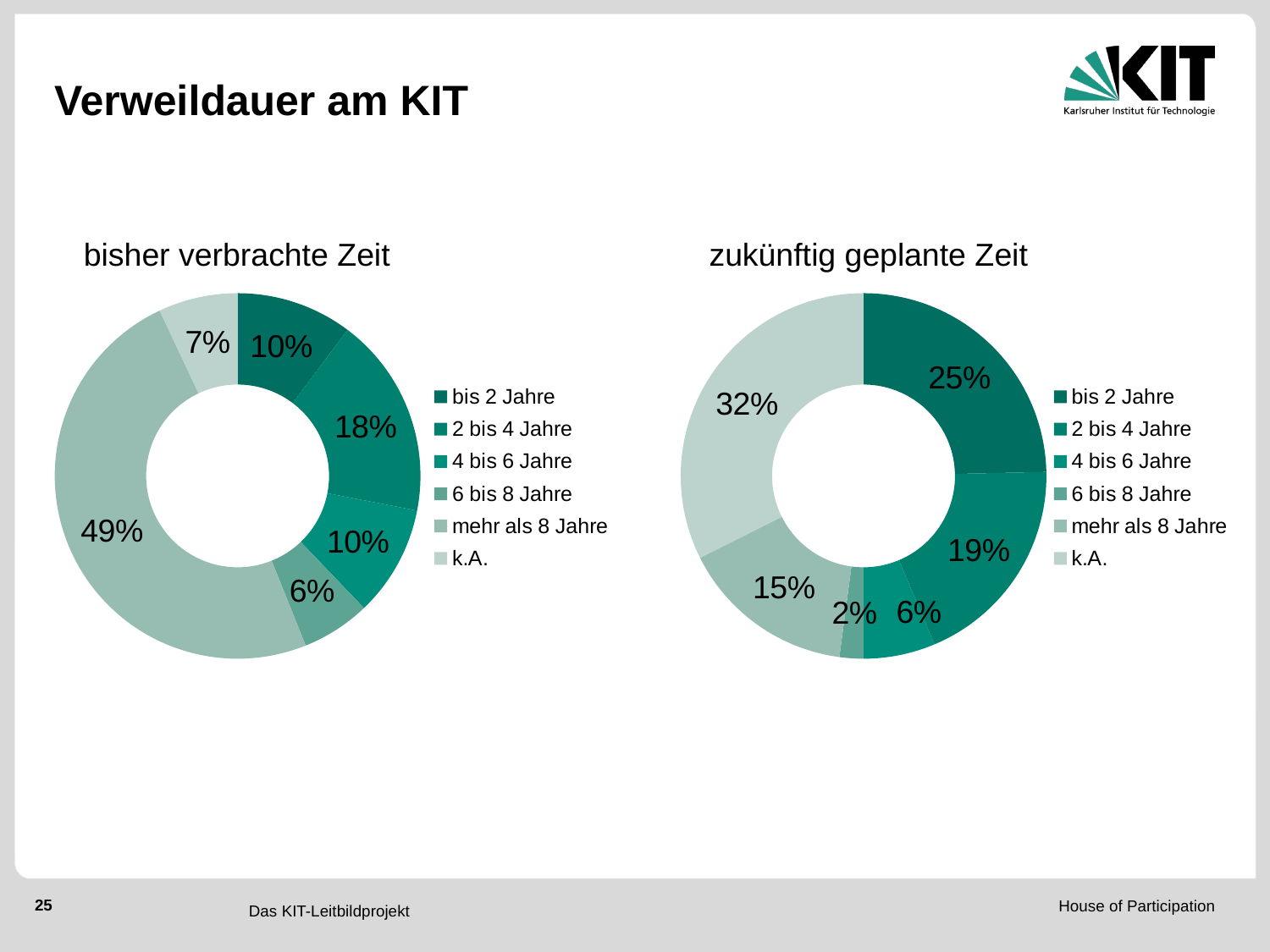
In the chart titled "zukünftig geplante Zeit", what share is shown for "k.A."? 32% In the chart titled "bisher verbrachte Zeit", what is the difference between the shares for "2 bis 4 Jahre" and "6 bis 8 Jahre"? 12% In the chart titled "bisher verbrachte Zeit", what share is shown for "2 bis 4 Jahre"? 18% What type of chart is used for "zukünftig geplante Zeit"? Donut (pie) chart In the chart titled "zukünftig geplante Zeit", what is the difference between the shares for "k.A." and "mehr als 8 Jahre"? 17% In the chart titled "bisher verbrachte Zeit", what share is shown for "mehr als 8 Jahre"? 49% Which chart shows a larger share for "bis 2 Jahre", "bisher verbrachte Zeit" or "zukünftig geplante Zeit"? zukünftig geplante Zeit In the chart titled "zukünftig geplante Zeit", which category has the smallest share? 6 bis 8 Jahre In the chart titled "zukünftig geplante Zeit", what share is shown for "bis 2 Jahre"? 25% How many categories does the legend of the chart titled "bisher verbrachte Zeit" list? 6 In the chart titled "bisher verbrachte Zeit", which category has the largest share? mehr als 8 Jahre What is the title of the chart on the left side of the slide? bisher verbrachte Zeit